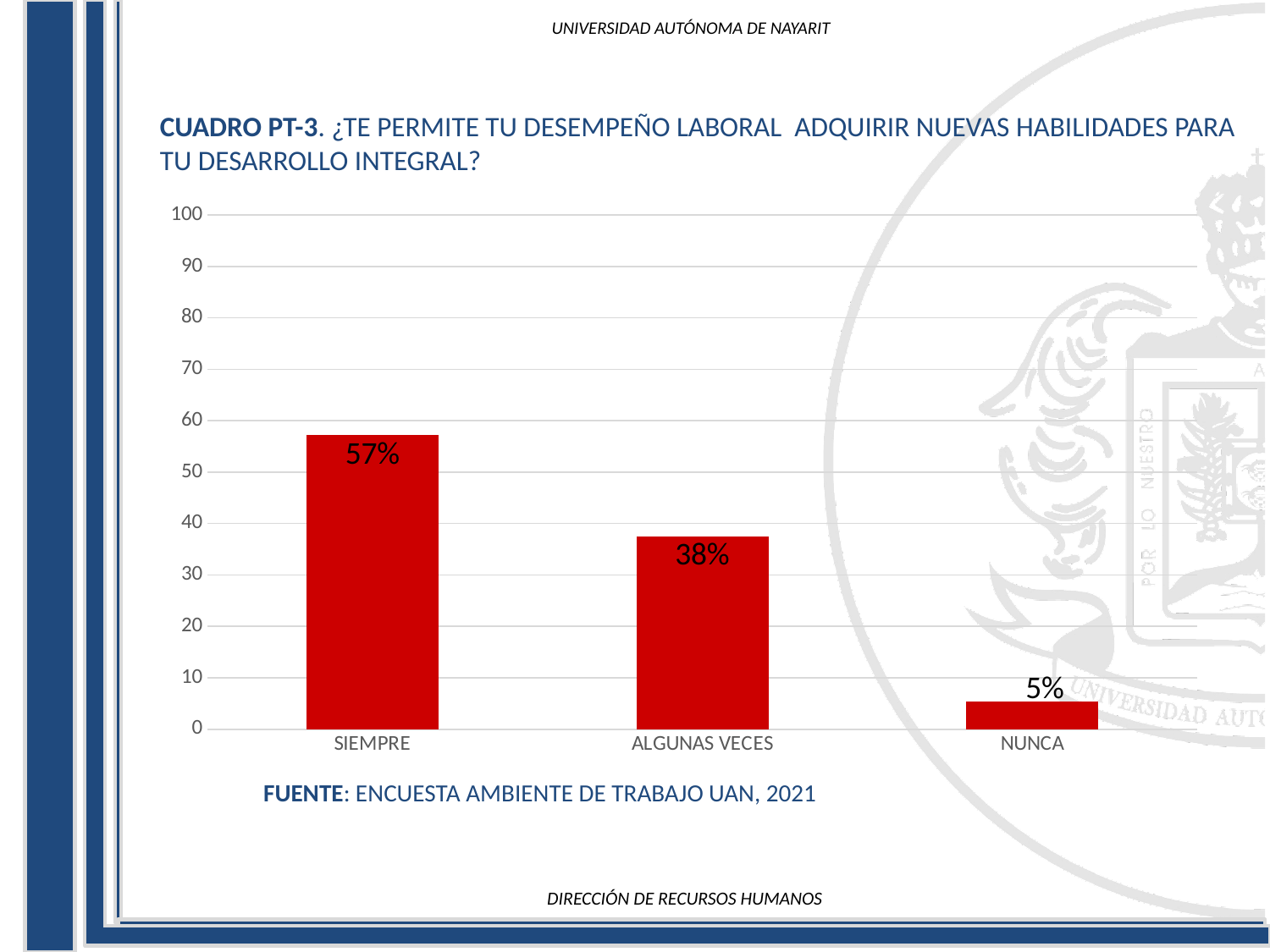
Which category has the highest value? SIEMPRE What kind of chart is shown on the slide? bar chart What is the value for ALGUNAS VECES? 38% Is the value for SIEMPRE greater or less than 50? greater What is the difference between the values for ALGUNAS VECES and NUNCA? 33% What is the source cited below the chart? ENCUESTA AMBIENTE DE TRABAJO UAN, 2021 What is the difference between the values for SIEMPRE and ALGUNAS VECES? 19% What is the value for SIEMPRE? 57% How many categories are shown on the x axis? 3 Which is larger, the value for ALGUNAS VECES or the value for NUNCA? ALGUNAS VECES Which category has the lowest value? NUNCA What is the value for NUNCA? 5%